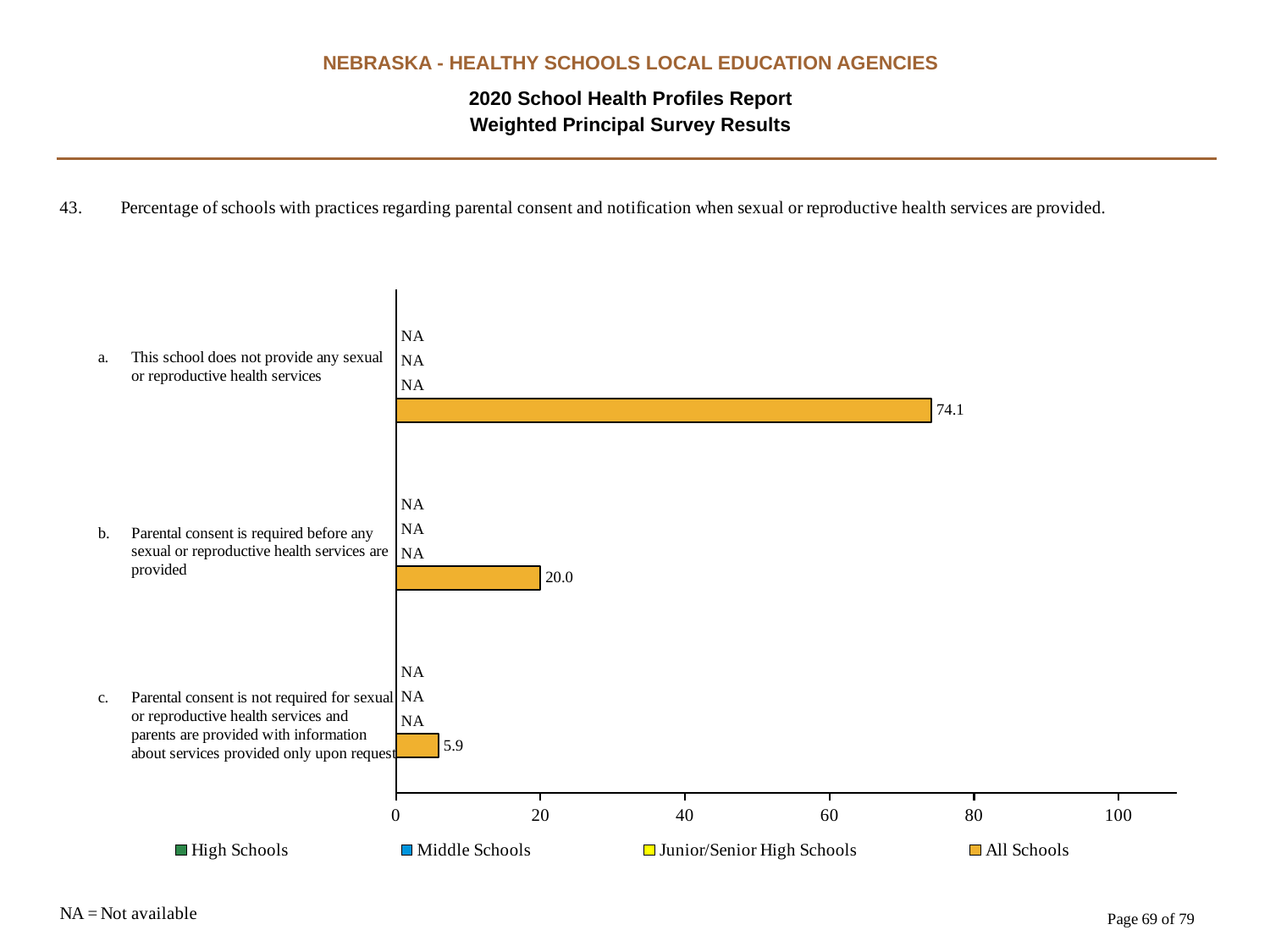
How many categories (practices) are shown on the chart? 3 What is the difference between the All Schools values for category a and category b? 54.1 Which category has the highest All Schools value? a. This school does not provide any sexual or reproductive health services Which category has the lowest All Schools value? c. Parental consent is not required for sexual or reproductive health services and parents are provided with information about services provided only upon request What value is shown for High Schools in category a? NA What is the All Schools value for category c, "Parental consent is not required ... only upon request"? 5.9 What kind of chart is shown on the slide? bar chart Which is larger for All Schools: category b or category c? category b What is the All Schools value for category b, "Parental consent is required before any sexual or reproductive health services are provided"? 20.0 Is the All Schools value for category a greater or less than 60? greater How many series does the legend list? 4 What is the All Schools value for category a, "This school does not provide any sexual or reproductive health services"? 74.1